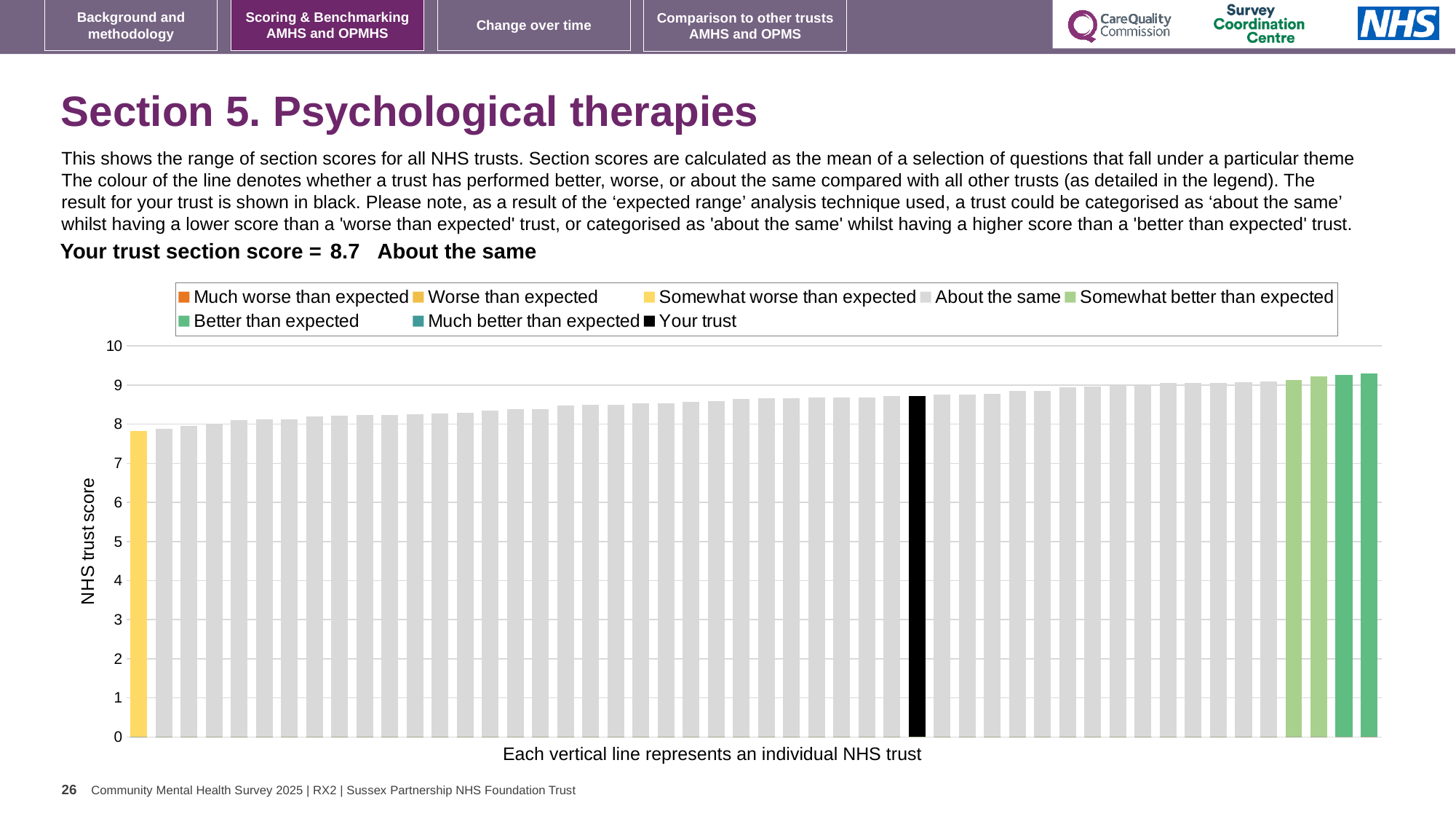
What is the section score for your trust shown on the slide? 8.7 How many bars are coloured green (Somewhat better than expected or Better than expected) in the chart? 4 Is the value of the black 'Your trust' bar greater or less than 9? less How many entries does the chart legend list? 8 Is the value of the black 'Your trust' bar greater or less than 8? greater Do the bar values rise or fall from left to right along the x axis? rise Is the value of the tallest bar in the chart greater or less than 9? greater What kind of chart is shown on the slide? bar chart What is the label on the y axis of the chart? NHS trust score What colour is the bar representing your trust? black